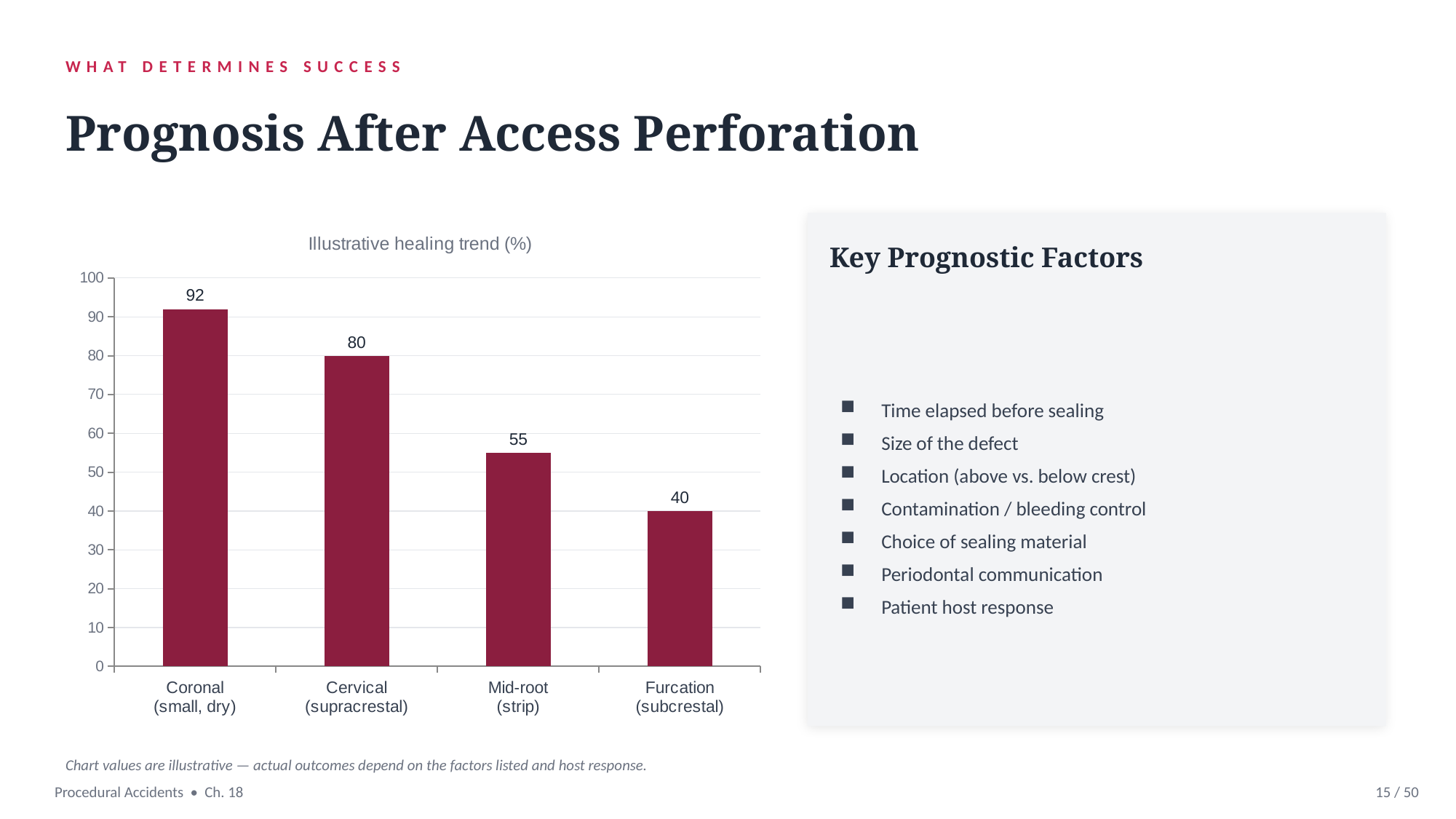
What is the value for Mid-root (strip)? 55 Which category has the lowest value? Furcation (subcrestal) What is the value for Cervical (supracrestal)? 80 Do the values rise or fall from left to right along the x axis? fall What kind of chart is shown on the slide? bar chart Is the value for Mid-root (strip) greater or less than 60? less How many categories are shown on the chart? 4 What is the value for Coronal (small, dry)? 92 What is the value for Furcation (subcrestal)? 40 Which category has the highest value? Coronal (small, dry) What is the difference between the values for Coronal (small, dry) and Furcation (subcrestal)? 52 Which is larger, the value for Cervical (supracrestal) or Mid-root (strip)? Cervical (supracrestal)